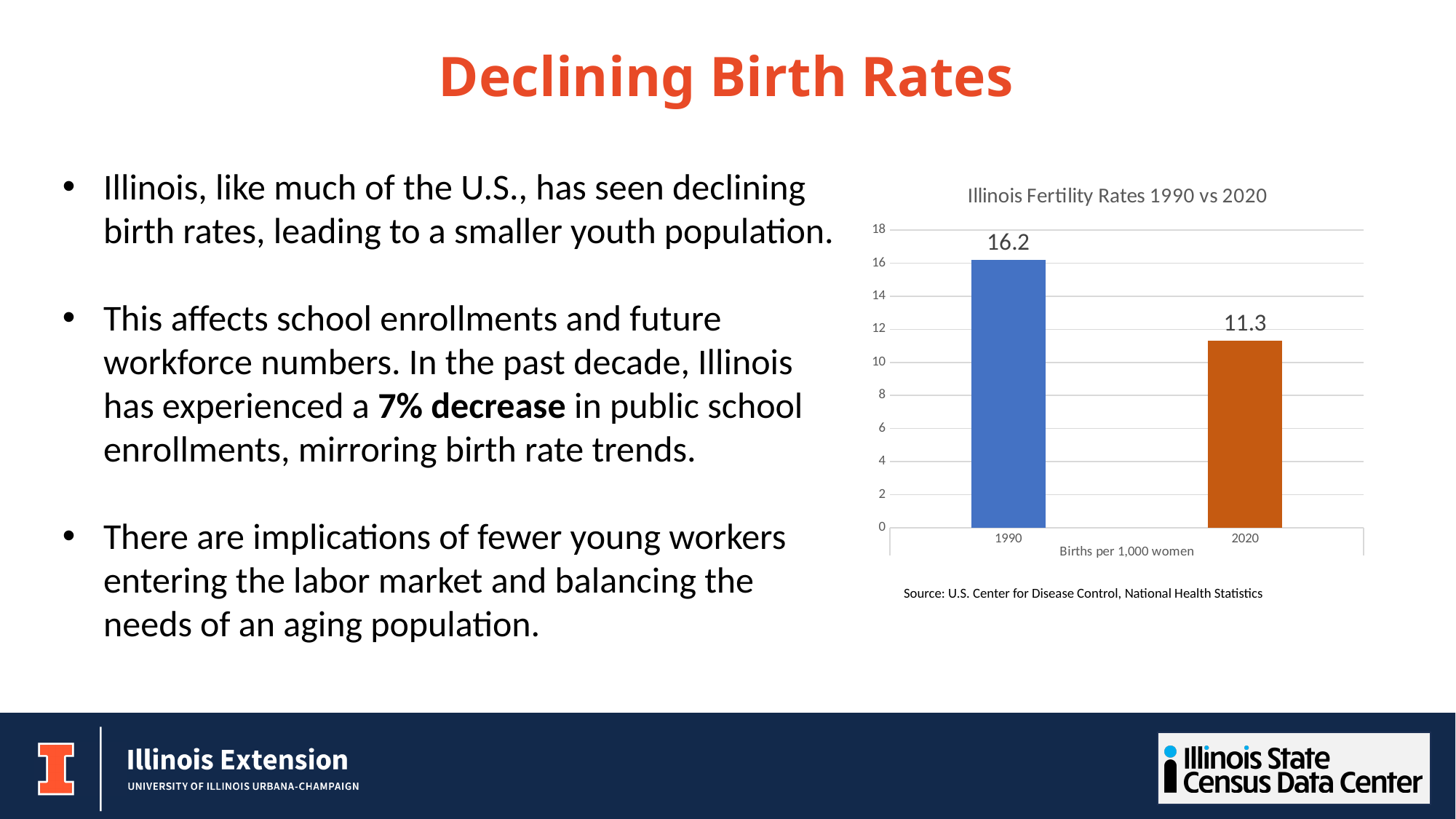
What is the Illinois fertility rate for 2020 shown in the chart? 11.3 Which year has the lower fertility rate in the chart? 2020 Is the fertility rate for 1990 greater or less than the rate for 2020? greater Do the fertility rates rise or fall from 1990 to 2020? Fall Is the value for 2020 greater or less than 12? less What is the title of the chart? Illinois Fertility Rates 1990 vs 2020 How many bars are plotted in the chart? 2 By how much did the Illinois fertility rate fall from 1990 to 2020? 4.9 Which year has the higher fertility rate in the chart? 1990 What is the Illinois fertility rate for 1990 shown in the chart? 16.2 Is the value for 1990 greater or less than 14? greater What kind of chart is shown on the slide? Bar chart